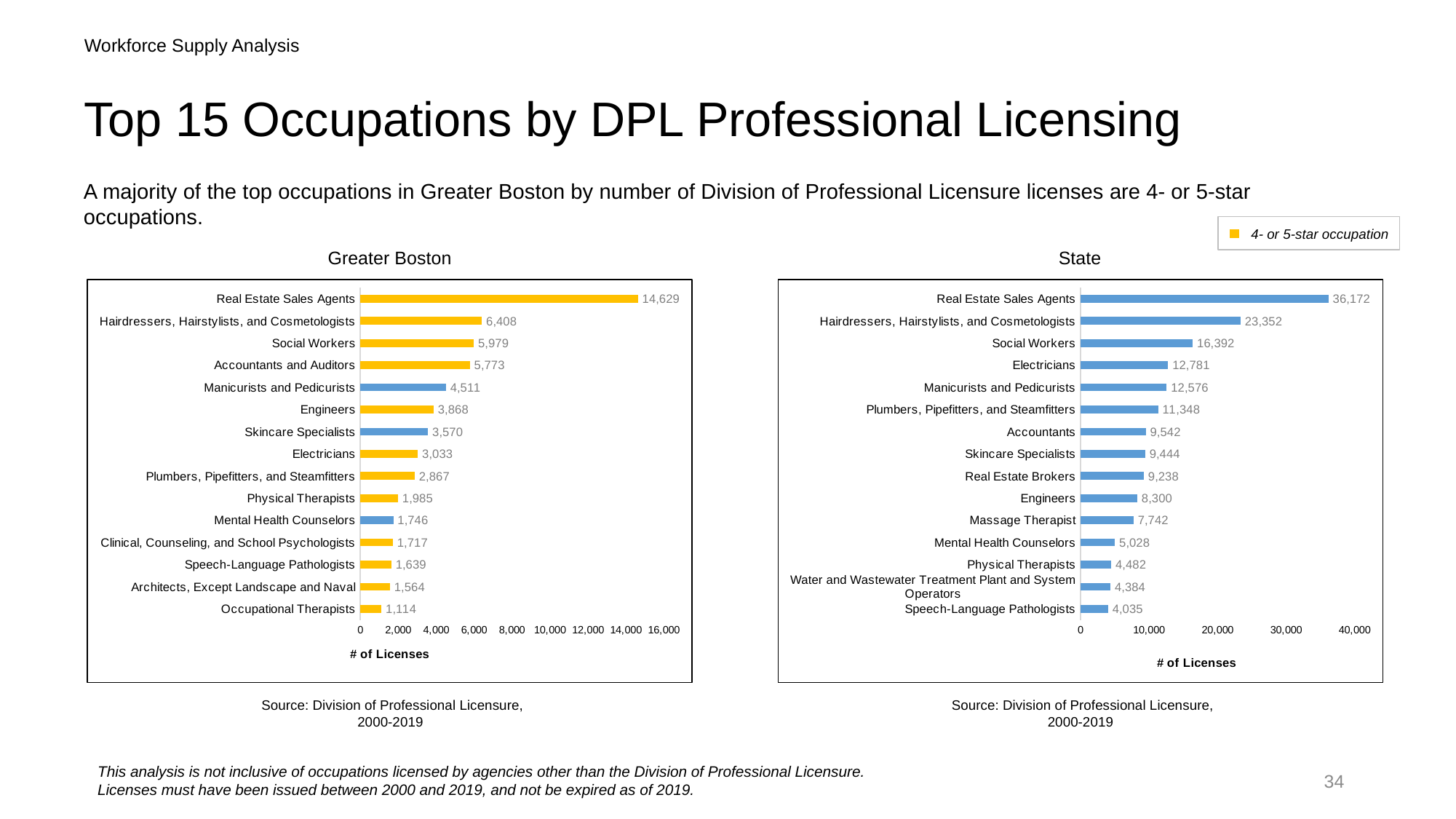
In the Greater Boston chart, what does the yellow bar colour indicate? 4- or 5-star occupation In the Greater Boston chart, which occupation has the lowest number of licenses? Occupational Therapists In the State chart, is the value for Social Workers greater or less than 20,000? less What is the x-axis label on the Greater Boston chart? # of Licenses In the Greater Boston chart, what is the difference in licenses between Social Workers and Accountants and Auditors? 206 What type of chart is the State chart? Bar chart In the Greater Boston chart, which has more licenses: Engineers or Skincare Specialists? Engineers In the State chart, how many licenses are shown for Electricians? 12,781 In the State chart, which occupation has the highest number of licenses? Real Estate Sales Agents How many occupations are listed in the Greater Boston chart? 15 In the Greater Boston chart, how many licenses are shown for Real Estate Sales Agents? 14,629 In the State chart, what is the difference in licenses between Real Estate Sales Agents and Hairdressers, Hairstylists, and Cosmetologists? 12,820